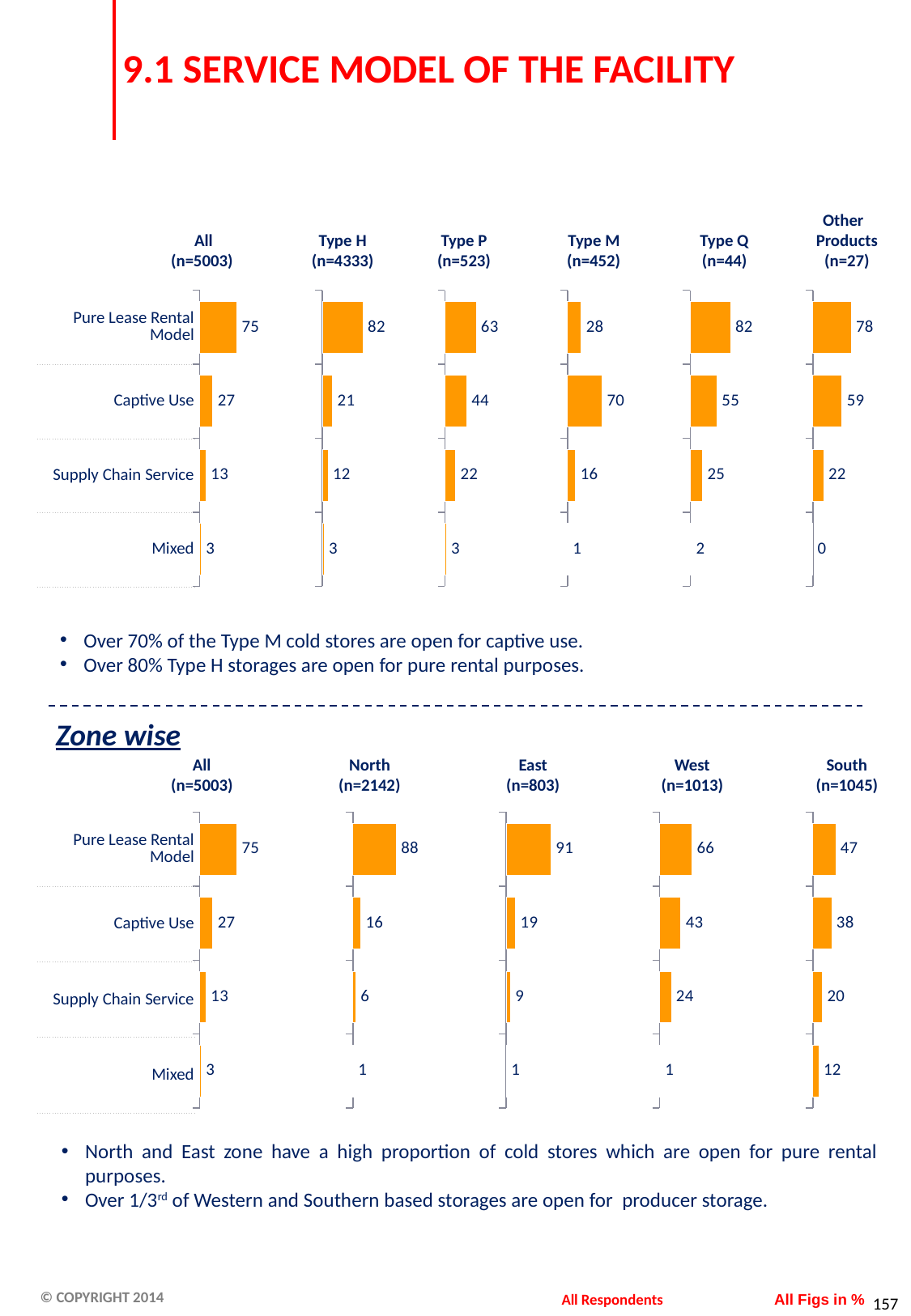
In the top set of charts, which category has the highest value in the Type M (n=452) chart? Captive Use In the Zone wise charts, what is the value for Mixed in the South (n=1045) chart? 12 In the Zone wise charts, which category has the lowest value in the North (n=2142) chart? Mixed In the Zone wise charts, what is the value for Pure Lease Rental Model in the East (n=803) chart? 91 How many categories are shown in each of the Zone wise charts? 4 In the top set of charts, what is the value for Pure Lease Rental Model in the Type H (n=4333) chart? 82 What type of chart is used in the Zone wise section? Bar chart In the top set of charts, what is the value for Supply Chain Service in the Type Q (n=44) chart? 25 In the Zone wise charts, which is larger: the Captive Use value for West (n=1013) or for South (n=1045)? West (n=1013) How many separate zone charts are shown in the Zone wise section? 5 In the top set of charts, what is the value for Captive Use in the Type M (n=452) chart? 70 In the top set of charts, what is the difference between the Pure Lease Rental Model values in the Type H (n=4333) chart and the Type P (n=523) chart? 19